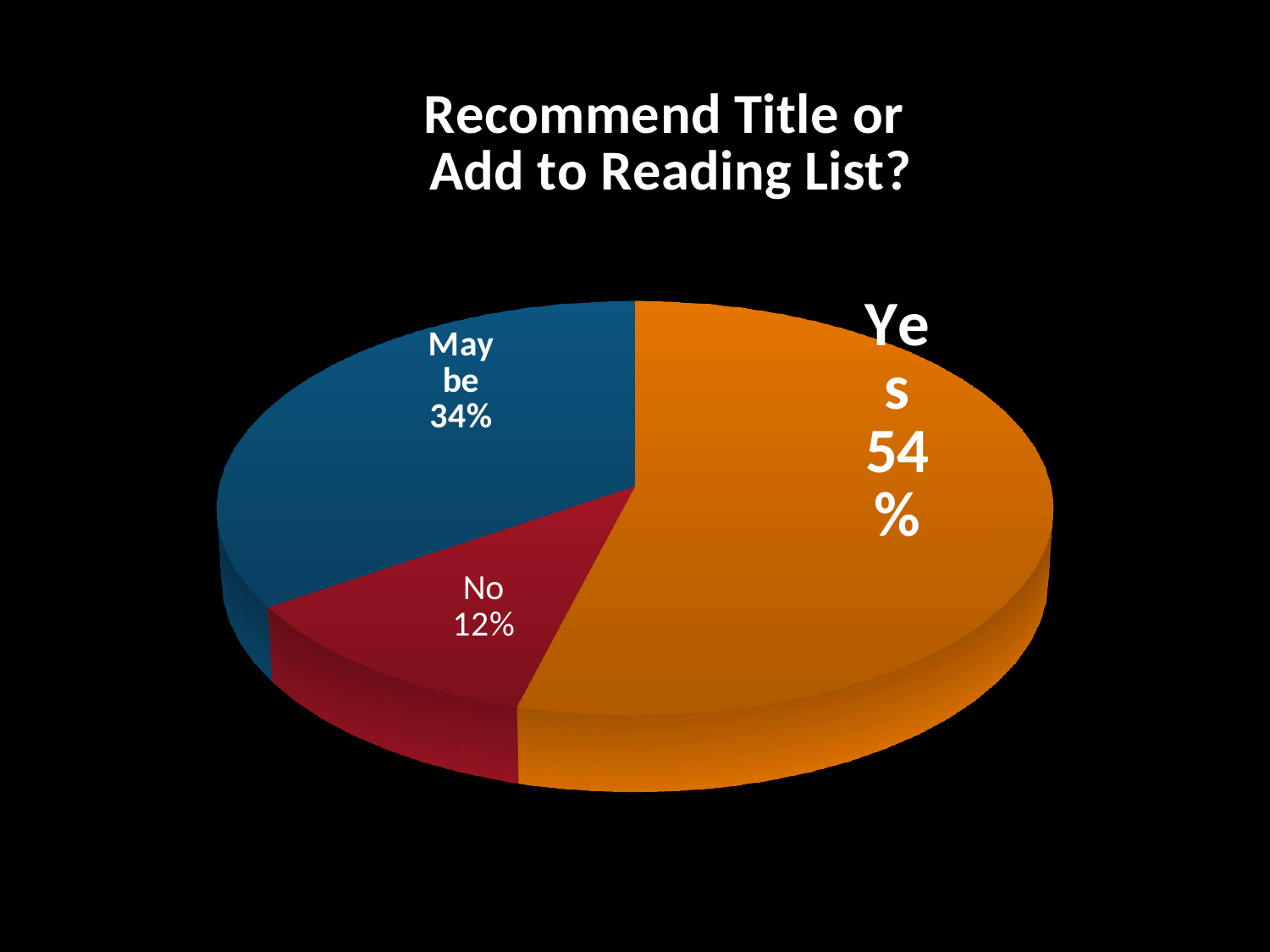
What is the difference in percentage points between "Yes" and "Maybe"? 20 What kind of chart is shown on the slide? Pie chart What percentage of responses are "No"? 12% What is the difference in percentage points between "Maybe" and "No"? 22 Which is larger, the share for "Maybe" or the share for "No"? Maybe How many slices does the pie chart have? 3 What colour is the "No" slice? Red What percentage of responses are "Yes"? 54% Which response has the largest share of the pie? Yes Which response has the smallest share of the pie? No What percentage of responses are "Maybe"? 34% What is the title of the chart? Recommend Title or Add to Reading List?